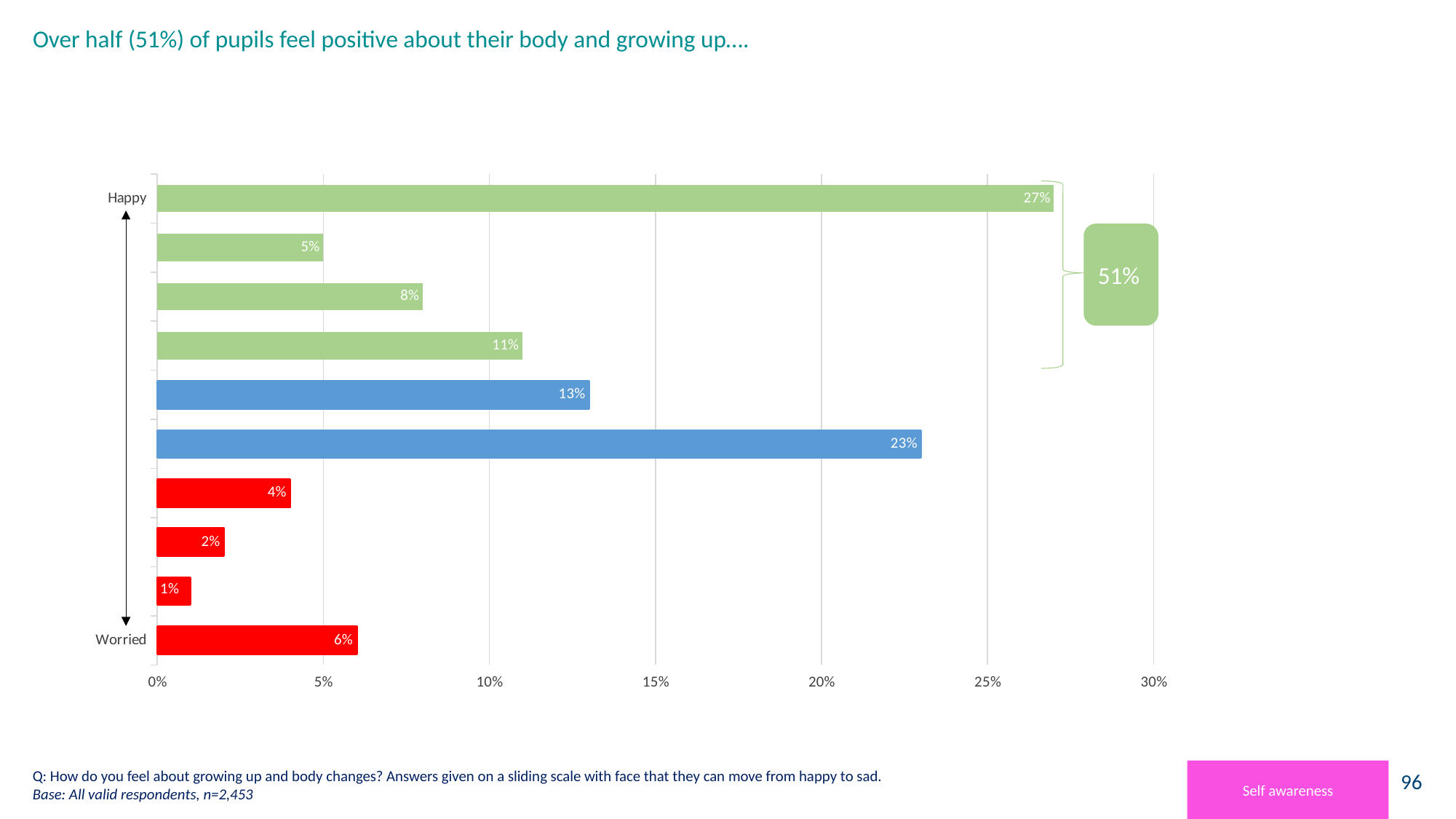
Which is larger, the Happy bar or the Worried bar? Happy What percentage is shown in the green callout box next to the bracket? 51% What kind of chart is shown on the slide? bar chart What is the highest value shown on the x axis? 30% How many bars are plotted in the chart? 10 Which bar has the highest value? Happy What is the value for the Happy bar? 27% What is the smallest value shown on any bar? 1% Is the value for Happy greater or less than 25%? greater What is the value for the Worried bar? 6% Is the value for Worried greater or less than 10%? less What is the difference between the Happy bar and the Worried bar? 21%